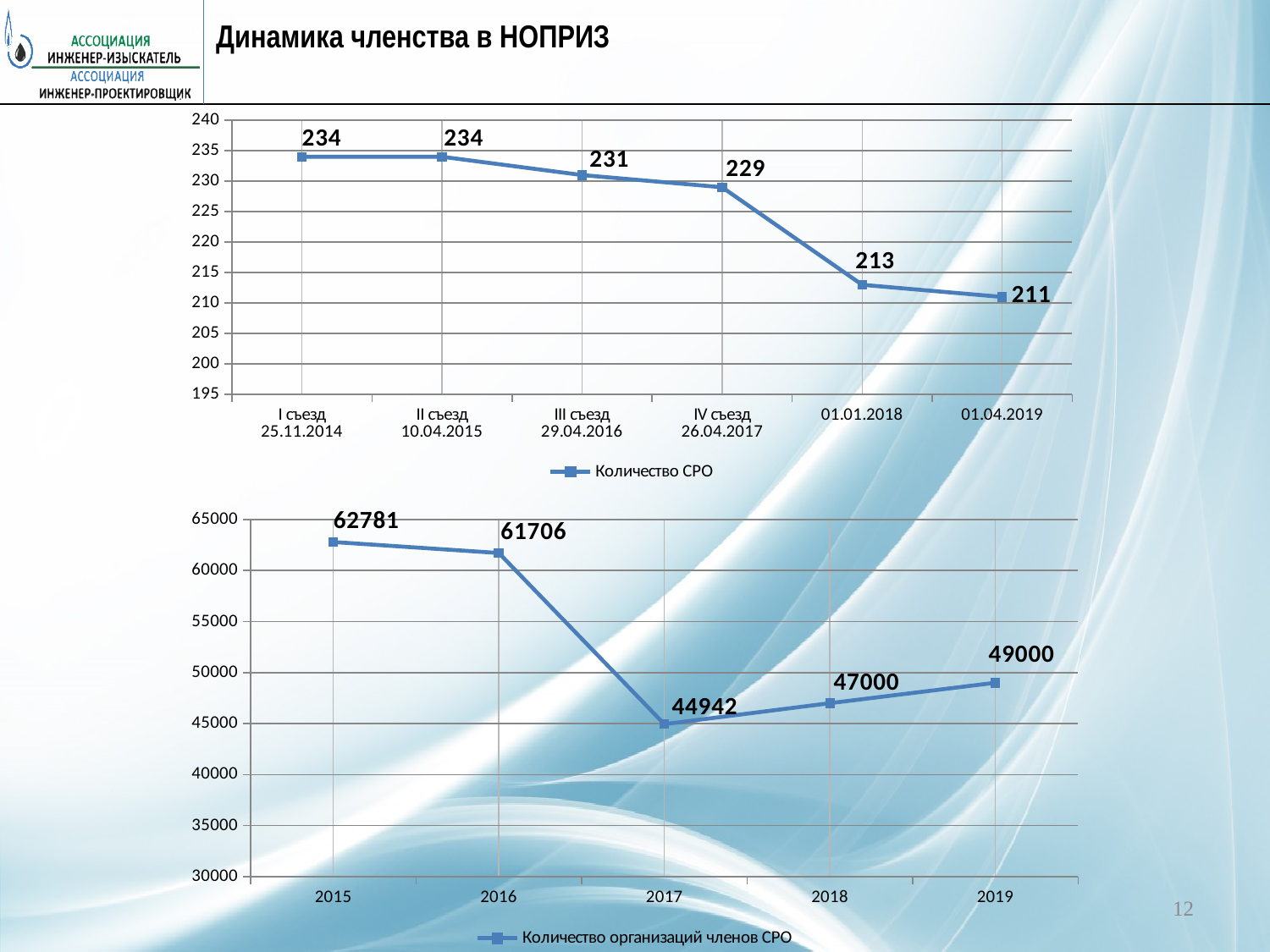
In the bottom chart (Количество организаций членов СРО), which year has the highest value? 2015 In the top chart (Количество СРО), what is the value for III съезд 29.04.2016? 231 In the top chart (Количество СРО), how many data points are plotted? 6 In the top chart (Количество СРО), what is the value for 01.01.2018? 213 In the bottom chart (Количество организаций членов СРО), which year has the lowest value? 2017 In the bottom chart (Количество организаций членов СРО), what is the difference between the values for 2015 and 2016? 1075 In the bottom chart (Количество организаций членов СРО), which is larger: the value for 2018 or the value for 2019? 2019 In the top chart (Количество СРО), do the values rise or fall from left to right? fall What type of chart is the bottom chart on the slide? line chart In the top chart (Количество СРО), what is the lowest value shown? 211 In the top chart (Количество СРО), what is the difference between the value for IV съезд 26.04.2017 and the value for 01.01.2018? 16 In the bottom chart (Количество организаций членов СРО), what is the value for 2017? 44942